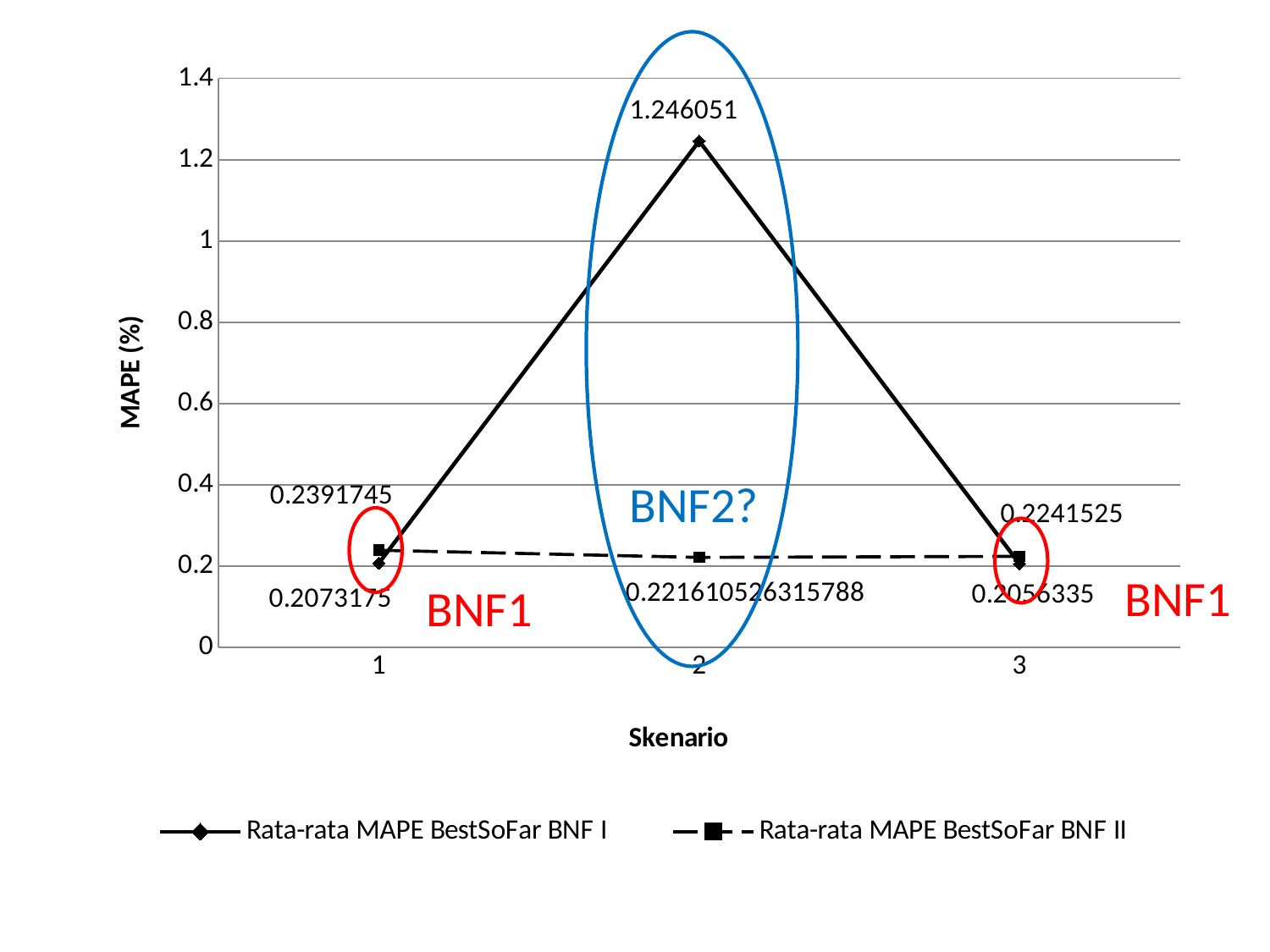
What is the difference between the BNF I values at Skenario 2 and Skenario 1? 1.0387335 What is the value of Rata-rata MAPE BestSoFar BNF I at Skenario 3? 0.2056335 What is the value of Rata-rata MAPE BestSoFar BNF II at Skenario 1? 0.2391745 At which Skenario does Rata-rata MAPE BestSoFar BNF I reach its highest value? 2 At which Skenario is Rata-rata MAPE BestSoFar BNF II lowest? 2 What type of chart is shown on the slide? Line chart What is the value of Rata-rata MAPE BestSoFar BNF I at Skenario 2? 1.246051 How many series does the legend list? 2 What is the value of Rata-rata MAPE BestSoFar BNF II at Skenario 2? 0.221610526315788 Which series has the larger value at Skenario 2, BNF I or BNF II? Rata-rata MAPE BestSoFar BNF I Is the value of Rata-rata MAPE BestSoFar BNF I at Skenario 2 greater or less than 1.2? greater How many Skenario categories are shown on the x axis? 3